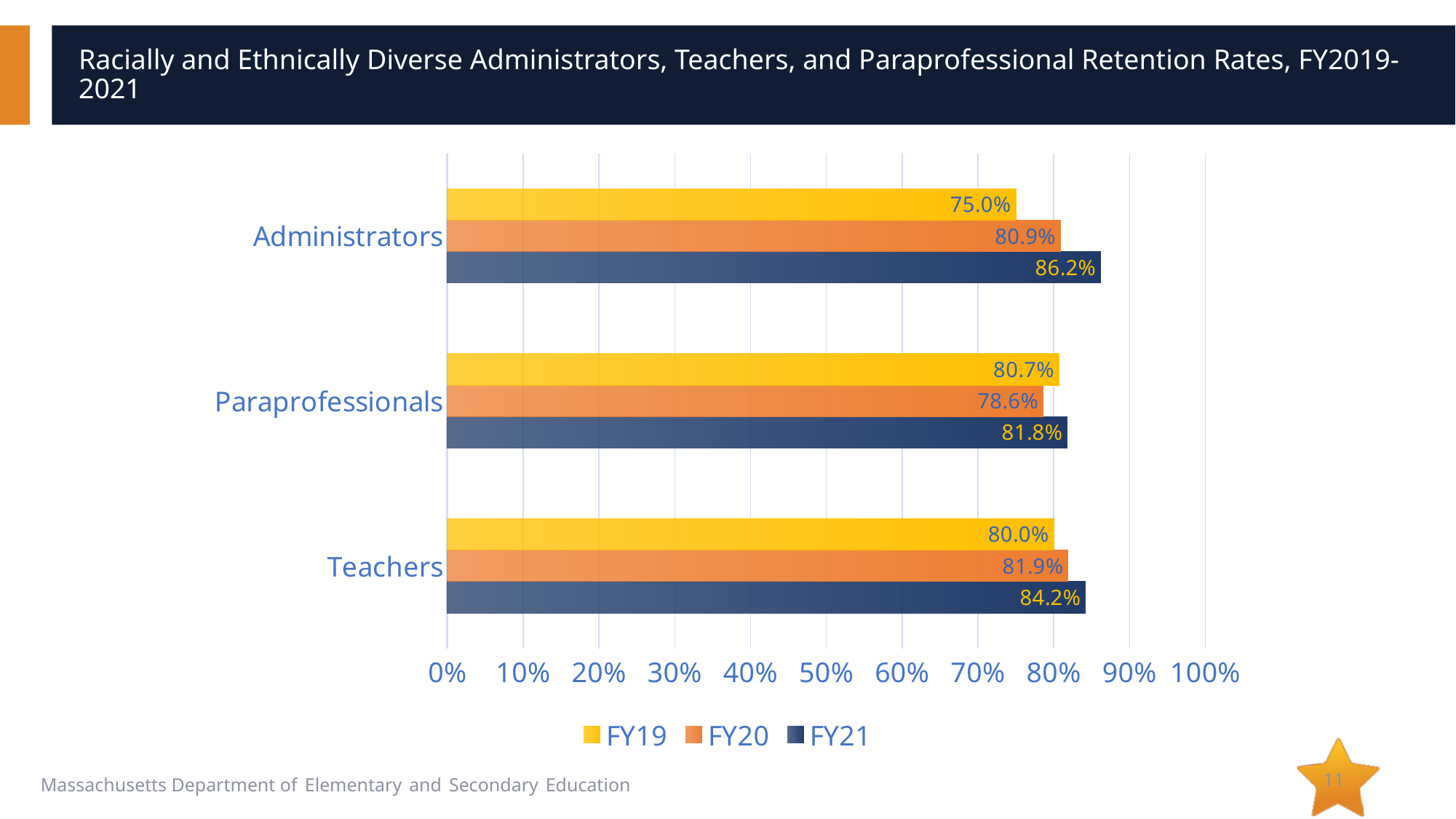
Which is larger for Paraprofessionals, the FY19 or the FY20 retention rate? FY19 What is the FY20 retention rate for Paraprofessionals? 78.6% What is the difference between the FY21 and FY19 retention rates for Administrators? 11.2% What kind of chart is shown on the slide? Bar chart Which series is shown in dark blue in the legend? FY21 Which category has the lowest FY19 retention rate? Administrators How many categories are shown on the chart? 3 Is the FY19 retention rate for Administrators greater or less than 80%? less What is the FY21 retention rate for Administrators? 86.2% What is the FY19 retention rate for Teachers? 80.0% Which category has the highest FY21 retention rate? Administrators How many series does the legend list? 3